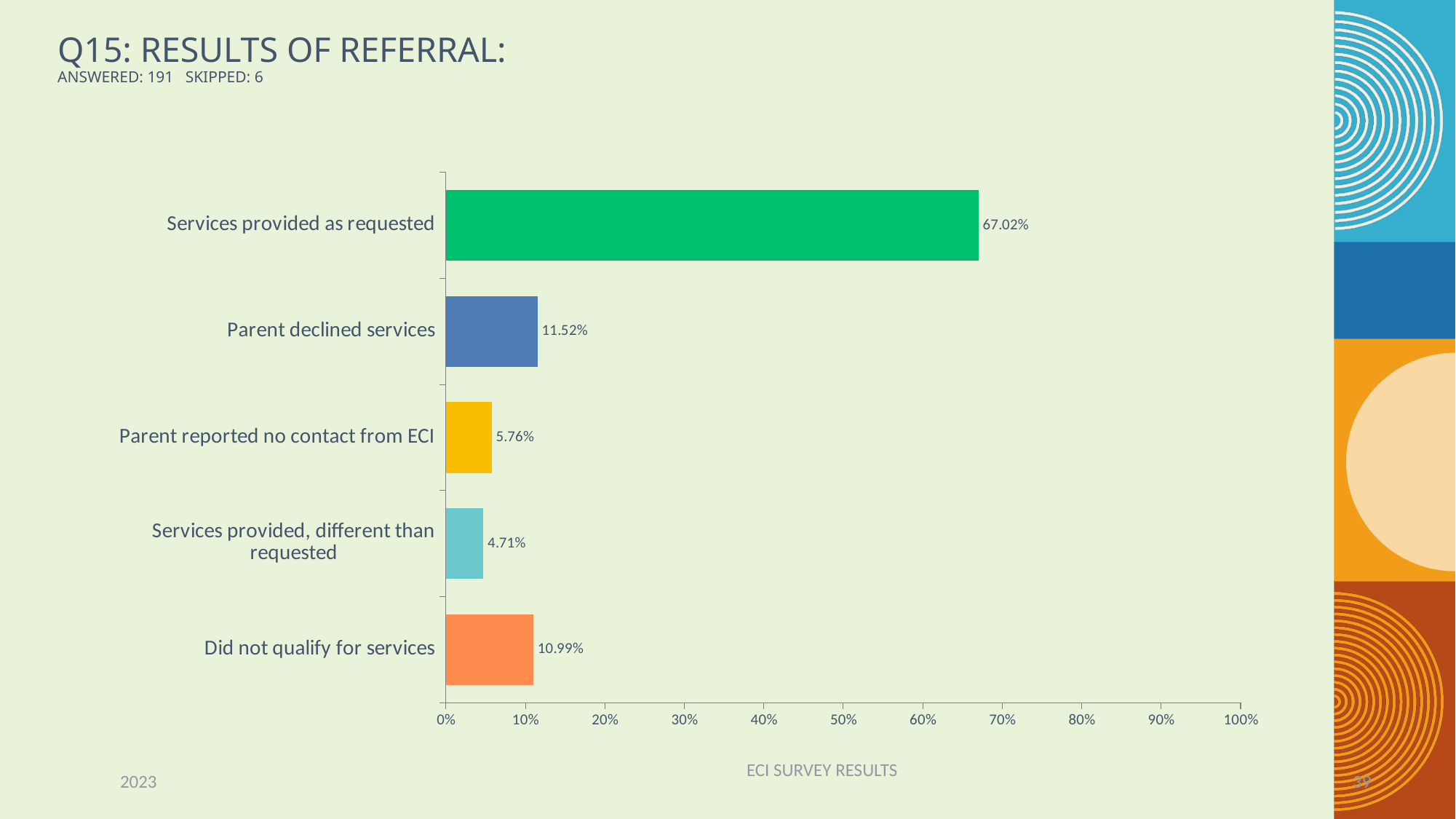
What is the value for 'Parent declined services'? 11.52% What is the value for 'Did not qualify for services'? 10.99% Which category has the highest value? Services provided as requested How many categories are shown in the chart? 5 What kind of chart is shown on the slide? Bar chart Is the value for 'Services provided as requested' greater or less than 60%? greater How many respondents answered Q15 according to the slide? 191 What percentage of responses were 'Services provided as requested'? 67.02% What is the difference between 'Services provided as requested' and 'Parent declined services'? 55.50% Which category has the lowest value? Services provided, different than requested What is the value for 'Parent reported no contact from ECI'? 5.76% Which is larger: 'Parent declined services' or 'Did not qualify for services'? Parent declined services